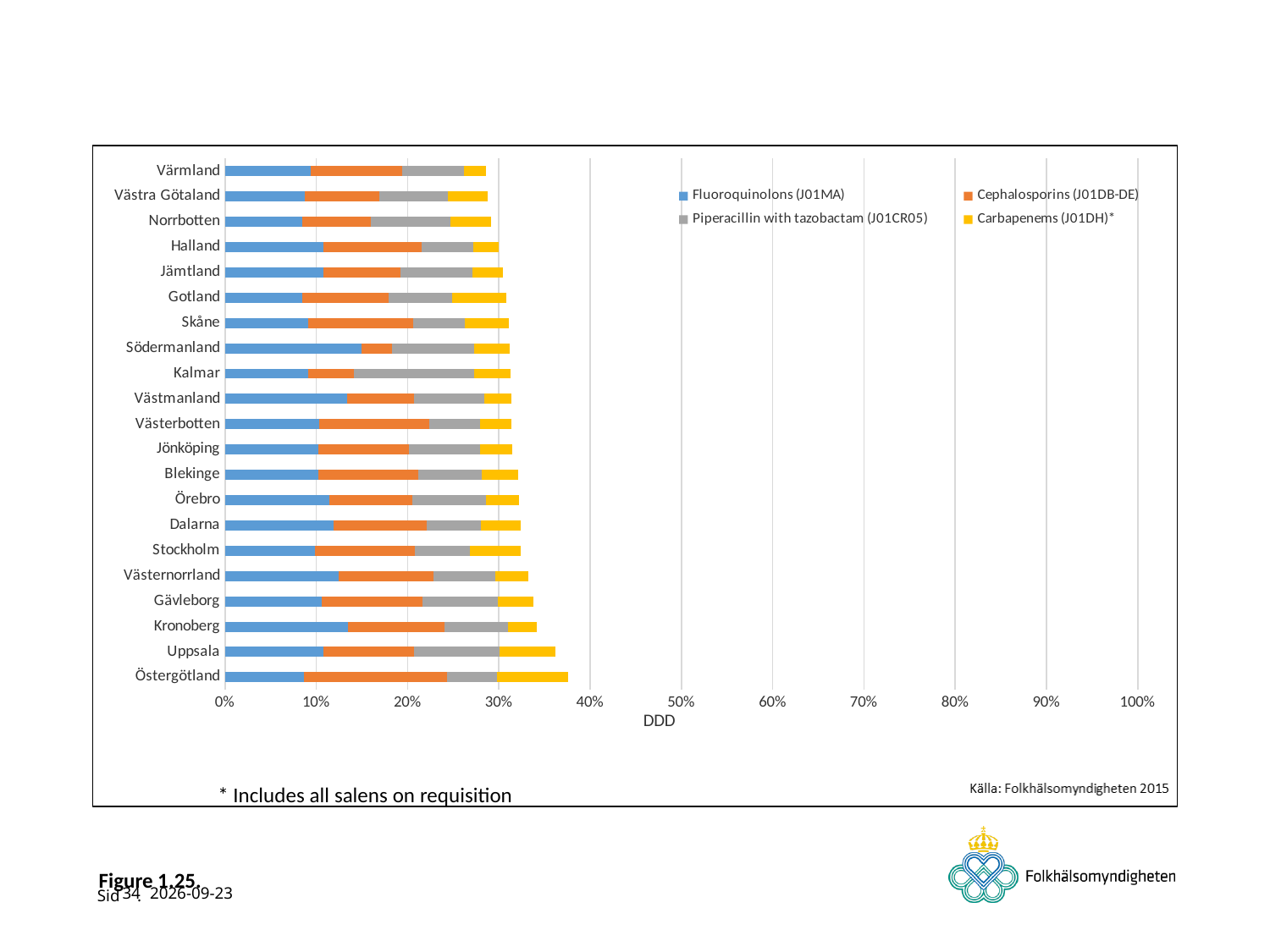
Which region has the longest total bar? Östergötland Is the total bar for Östergötland greater or less than 40%? less What kind of chart is shown on the slide? Stacked bar chart How many series does the legend list? 4 Is the Fluoroquinolons (J01MA) segment for Södermanland greater or less than 10%? greater Is the total bar for Östergötland greater or less than 30%? greater Which has the larger total bar, Uppsala or Värmland? Uppsala Which series is shown in yellow in the legend? Carbapenems (J01DH)* How many regions (categories) are plotted on the chart? 21 What is the title of the horizontal axis? DDD Which region has the shortest total bar? Värmland